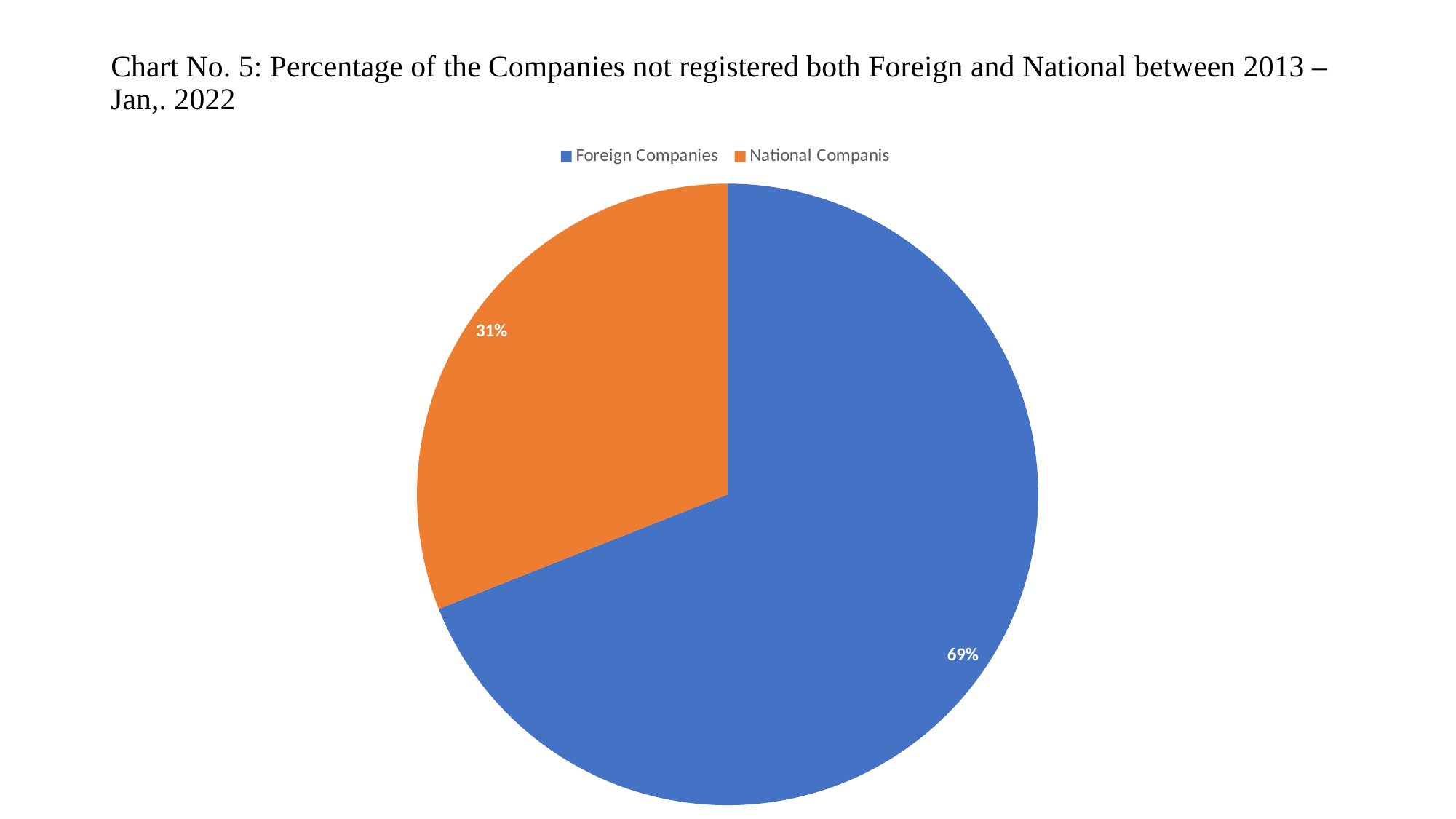
What colour is the slice for Foreign Companies? blue What is the difference in percentage points between Foreign Companies and National Companis? 38 What kind of chart is shown on the slide? pie chart What percentage of the pie is National Companis? 31% Which category has the largest share of the pie? Foreign Companies How many slices does the pie chart have? 2 What colour is the slice for National Companis? orange Which is larger, the share for Foreign Companies or the share for National Companis? Foreign Companies What percentage of the pie is Foreign Companies? 69% What is the total of the two slice percentages shown? 100% How many entries does the legend list? 2 Which category has the smallest share of the pie? National Companis